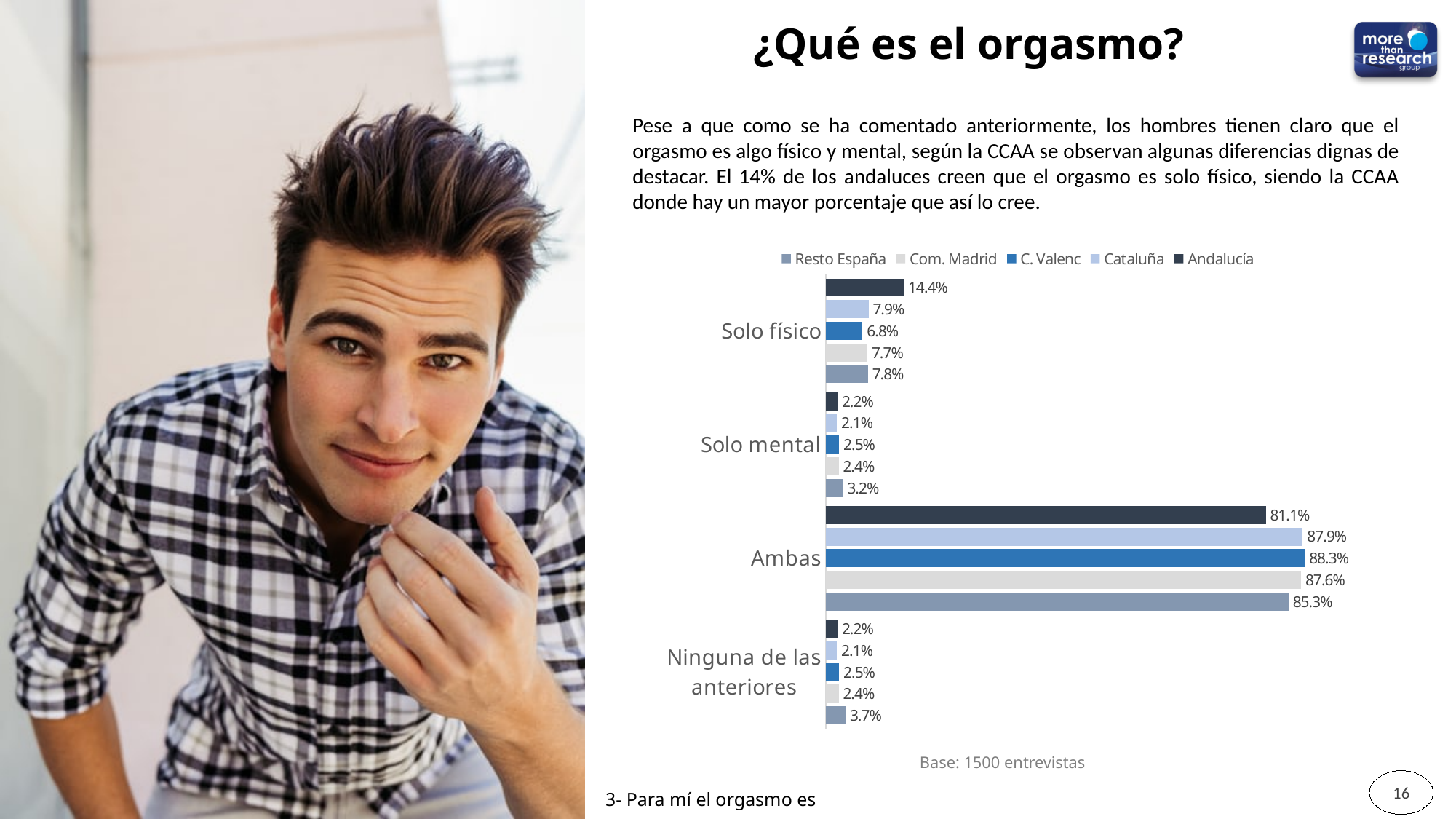
What is the value for C. Valenc in the 'Ambas' category? 88.3% What is the value for Resto España in the 'Ninguna de las anteriores' category? 3.7% What is the value for Andalucía in the 'Solo físico' category? 14.4% How many categories are shown on the chart? 4 What kind of chart is shown on the slide? Bar chart What is the difference between the Andalucía and Cataluña values in the 'Solo físico' category? 6.5% What base (number of interviews) is stated below the chart? Base: 1500 entrevistas Which region has the lowest value in the 'Ambas' category? Andalucía How many series does the legend list? 5 Which is larger in the 'Ambas' category: Cataluña or Resto España? Cataluña What is the value for Com. Madrid in the 'Solo mental' category? 2.4% Which region has the highest value in the 'Solo físico' category? Andalucía